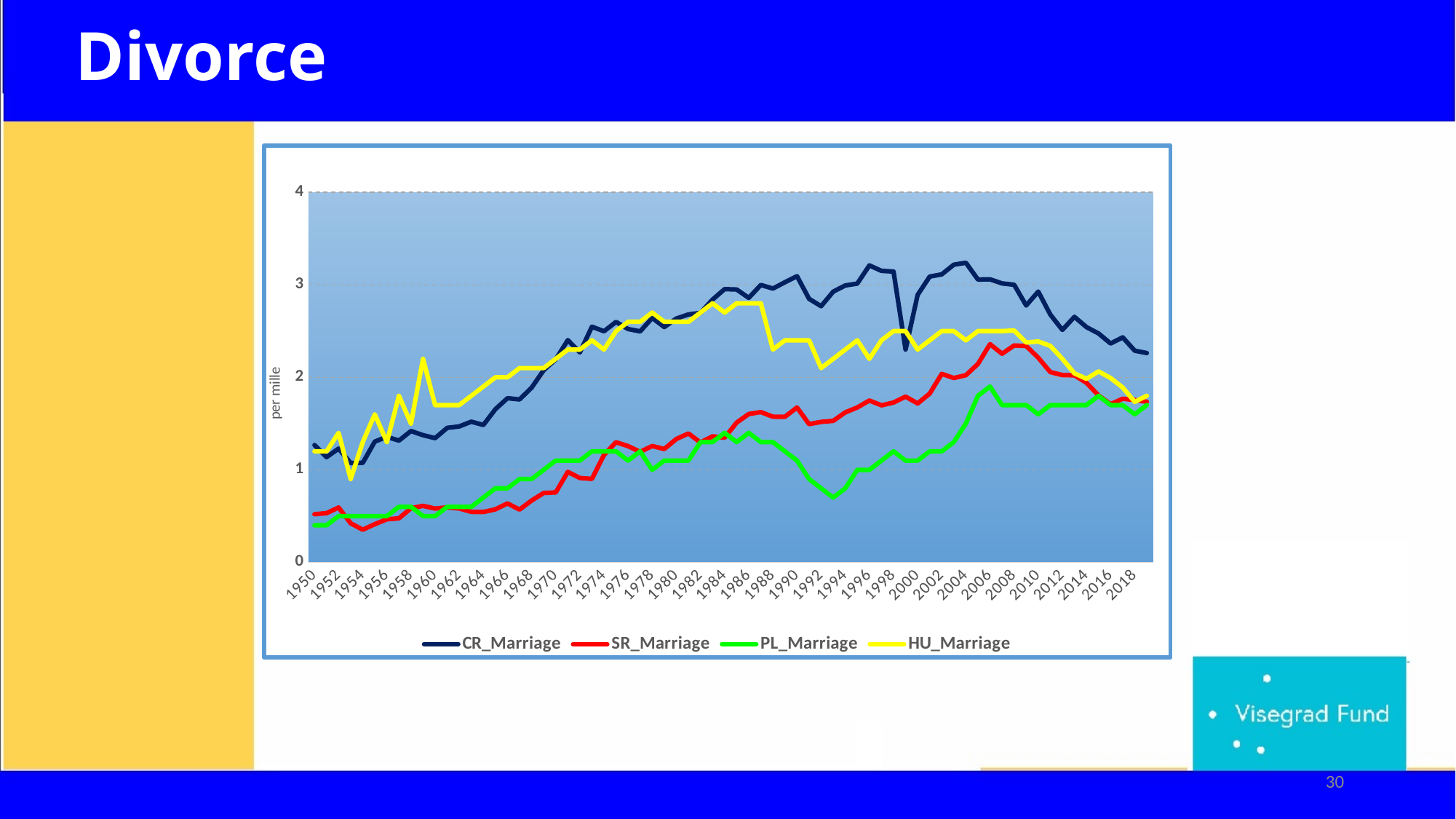
Is the value for CR_Marriage in 2004 greater or less than 3? greater Is the value for PL_Marriage in 1994 greater or less than 1? less What is the label on the vertical axis? per mille What kind of chart is shown on the slide? line chart Is the value for HU_Marriage in 1986 greater or less than 2? greater Which colour is used for the HU_Marriage line? yellow In 2008, which is larger, SR_Marriage or PL_Marriage? SR_Marriage How many series does the legend list? 4 Which series has the lowest value in 1994? PL_Marriage Which series has the highest value in 2004? CR_Marriage Does the CR_Marriage line rise or fall between 1950 and 1970? rise